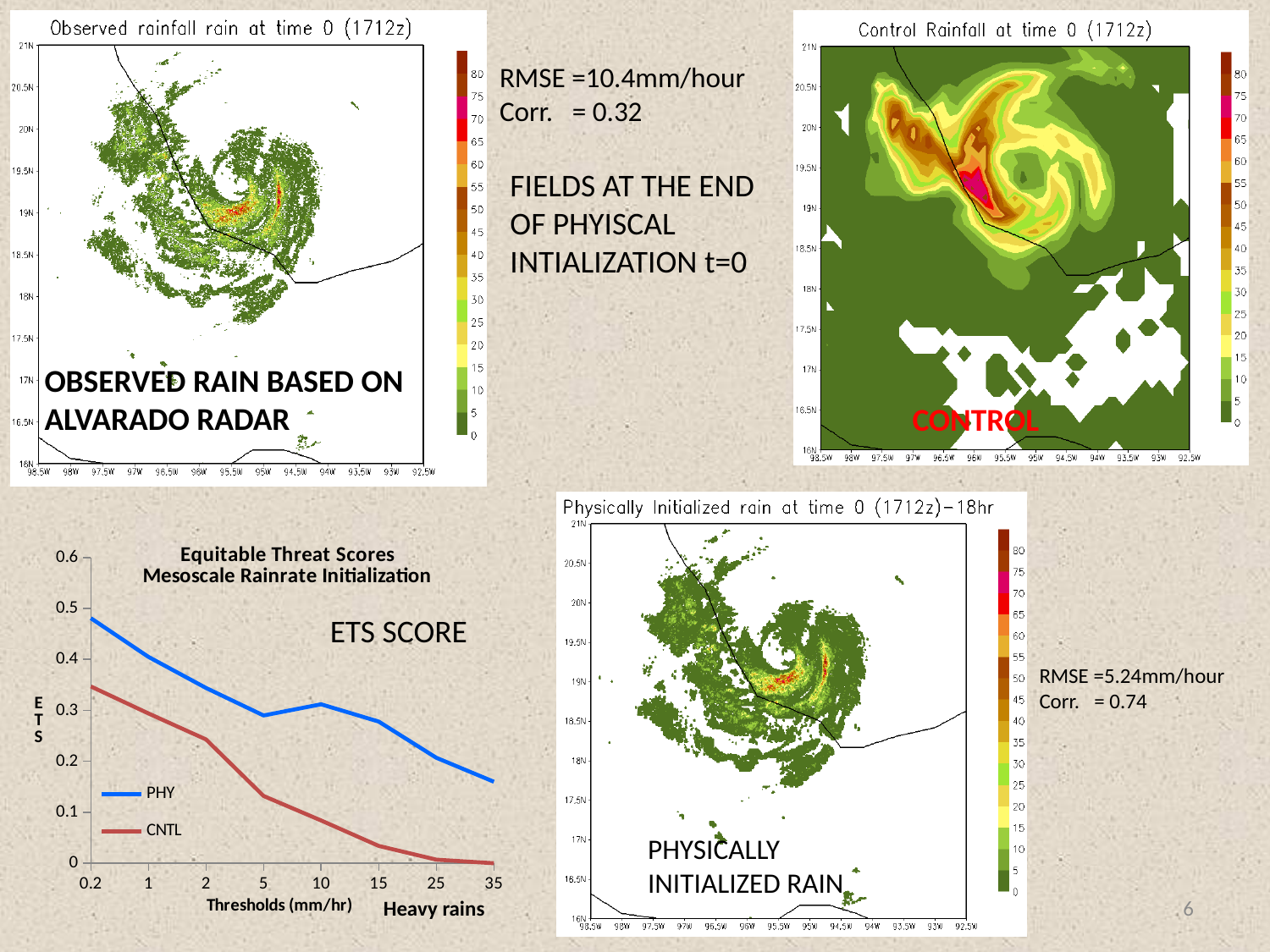
What kind of chart is the Equitable Threat Scores chart? line chart In the Equitable Threat Scores chart, is the CNTL value at the 15 threshold greater or less than 0.1? less In the Equitable Threat Scores chart, which series has the higher value at the 5 mm/hr threshold, PHY or CNTL? PHY In the Equitable Threat Scores chart, is the PHY value at the 35 threshold greater or less than 0.2? less In the Equitable Threat Scores chart, is the PHY value at the 0.2 threshold greater or less than 0.4? greater In the Equitable Threat Scores chart, at which threshold is the PHY series lowest? 35 What is the x-axis label of the Equitable Threat Scores chart? Thresholds (mm/hr) In the Equitable Threat Scores chart, does the CNTL series generally rise or fall as the threshold increases? fall In the Equitable Threat Scores chart, at which threshold is the PHY series highest? 0.2 Which two series are listed in the legend of the Equitable Threat Scores chart? PHY and CNTL How many threshold values are shown along the x axis of the Equitable Threat Scores chart? 8 How many series does the legend of the Equitable Threat Scores chart list? 2